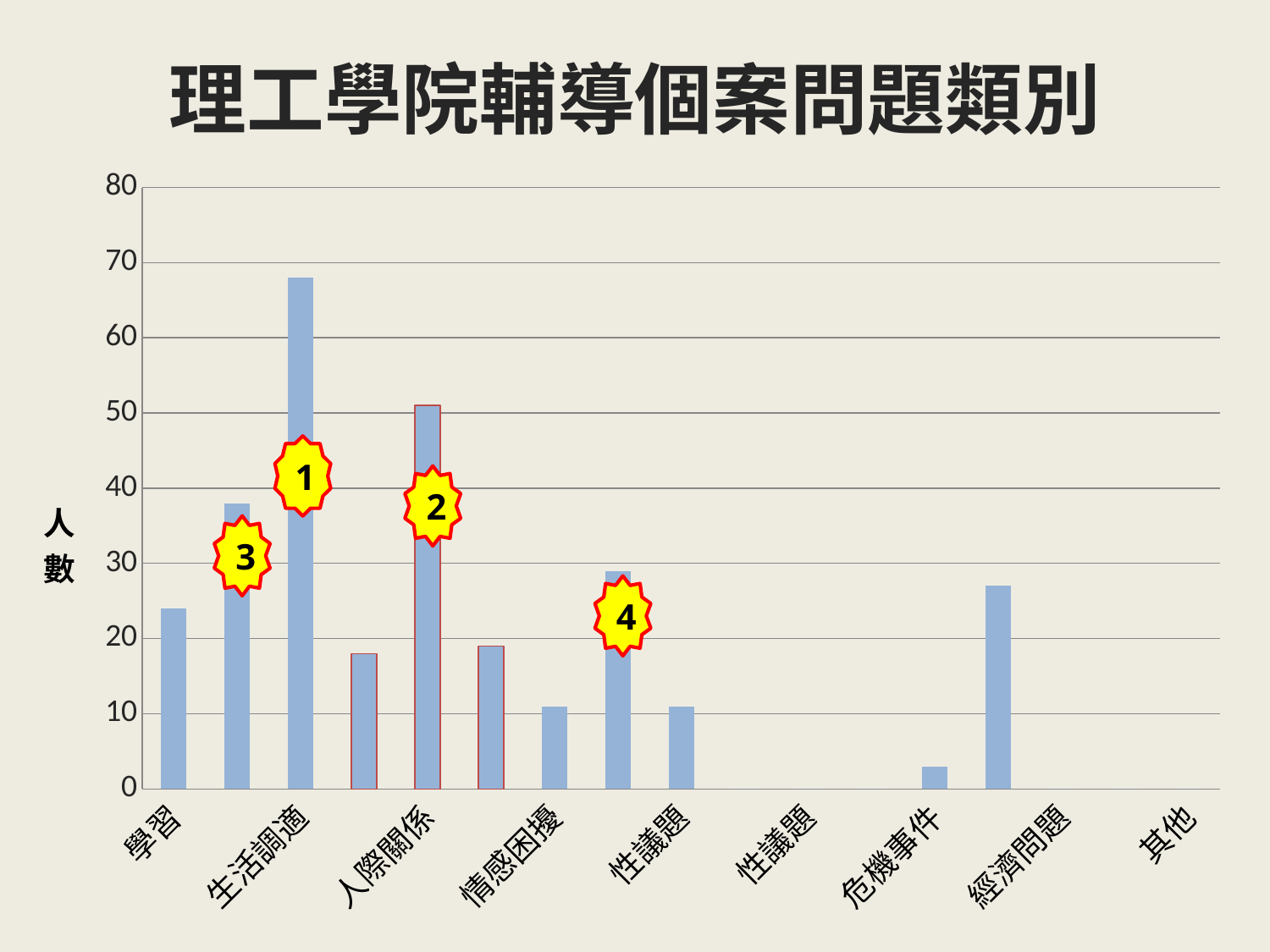
Is the value of the bar marked 3 greater or less than 40? less What is the highest tick value shown on the vertical axis? 80 Which numbered badge marks the tallest bar in the chart? 1 Is the value of the bar marked 3 greater or less than 30? greater Is the value of the bar marked 4 greater or less than 20? greater What is the title of the chart? 理工學院輔導個案問題類別 What is the label on the vertical axis of the chart? 人數 What kind of chart is shown on the slide? bar chart Which is larger, the bar marked 1 or the bar marked 2? the bar marked 1